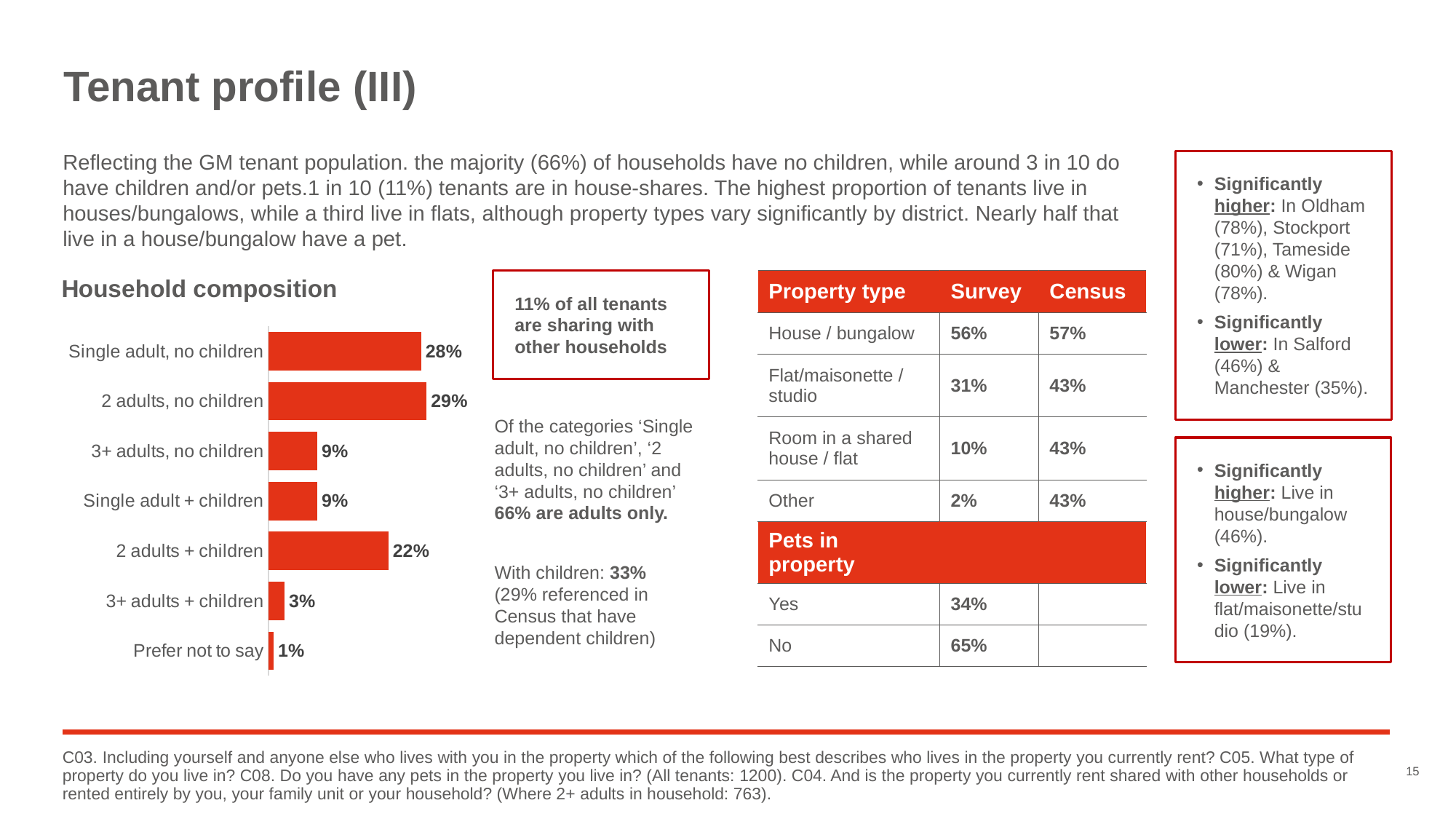
In the Household composition chart, what is the difference between '2 adults, no children' and 'Single adult, no children'? 1% In the Household composition chart, what is the value for 'Single adult, no children'? 28% What colour are the bars in the Household composition chart? Red In the Household composition chart, what is the value for '2 adults + children'? 22% How many categories are shown in the Household composition chart? 7 In the Household composition chart, what is the difference between '2 adults + children' and '3+ adults + children'? 19% In the Household composition chart, which is larger: '2 adults + children' or '3+ adults, no children'? 2 adults + children Which category has the highest value in the Household composition chart? 2 adults, no children In the Household composition chart, what is the value for 'Prefer not to say'? 1% In the Household composition chart, what is the value for '3+ adults + children'? 3% What type of chart is the Household composition chart? Bar chart Which category has the lowest value in the Household composition chart? Prefer not to say